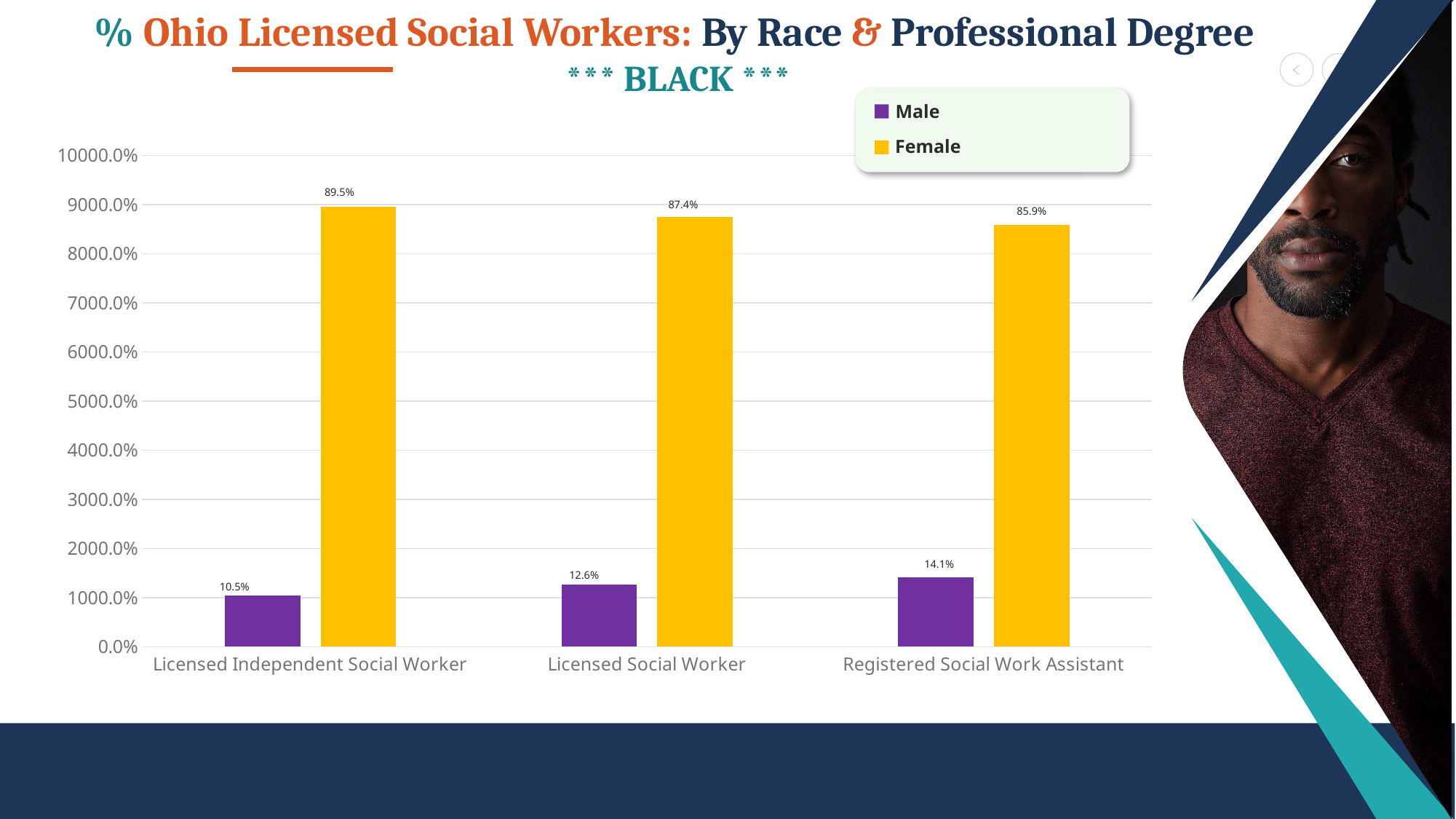
Which category has the lowest Female value? Registered Social Work Assistant What is the Male value for Registered Social Work Assistant? 14.1% Which colour represents the Female series in the legend? Yellow What is the Male value for Licensed Social Worker? 12.6% What is the Female value for Licensed Independent Social Worker? 89.5% What is the difference between the Female and Male values for Licensed Independent Social Worker? 79.0% Is the Female value for Licensed Social Worker larger or smaller than the Female value for Licensed Independent Social Worker? Smaller How many series does the legend list? 2 How many professional degree categories are shown on the x axis? 3 Which category has the highest Male value? Registered Social Work Assistant What is the Female value for Registered Social Work Assistant? 85.9% What type of chart is shown on the slide? Bar chart